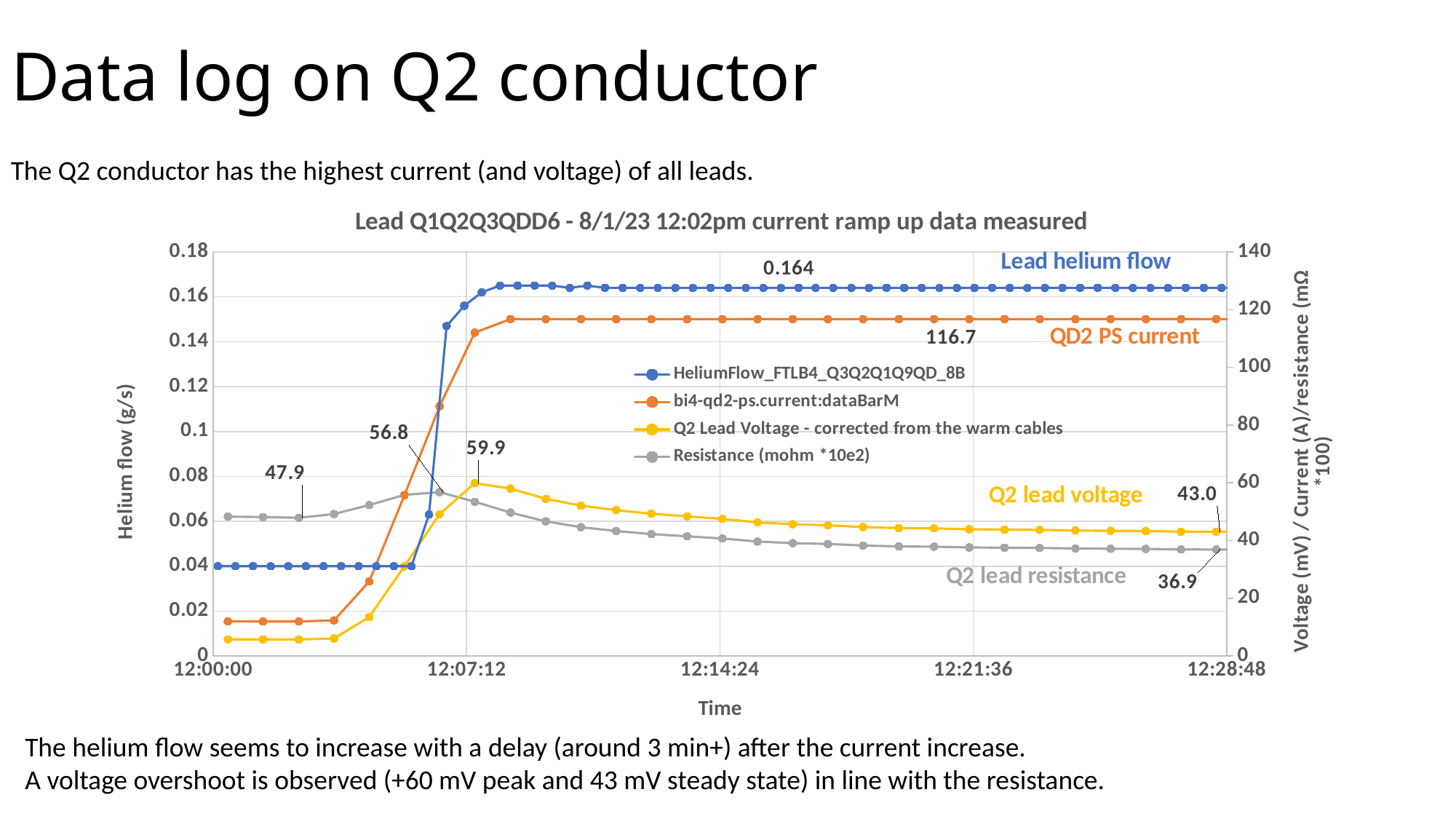
What is the labelled steady-state value of the lead helium flow? 0.164 How many series does the chart legend list? 4 What is the labelled value of the Q2 lead resistance at the end of the log? 36.9 What is the labelled value of the Q2 lead voltage at the end of the log? 43.0 What is the labelled value of the Q2 lead resistance at the start of the log? 47.9 What kind of chart is shown on the slide? line chart Is the lead helium flow at 12:00:00 greater or less than 0.06 g/s? less What is the labelled peak value of the Q2 lead resistance? 56.8 By how much does the Q2 lead voltage drop from its labelled peak (59.9) to its labelled end value (43.0)? 16.9 What is the labelled peak value of the Q2 lead voltage? 59.9 After its peak near 12:07:12, does the Q2 lead resistance rise or fall over the rest of the time axis? fall What is the labelled plateau value of the QD2 PS current? 116.7